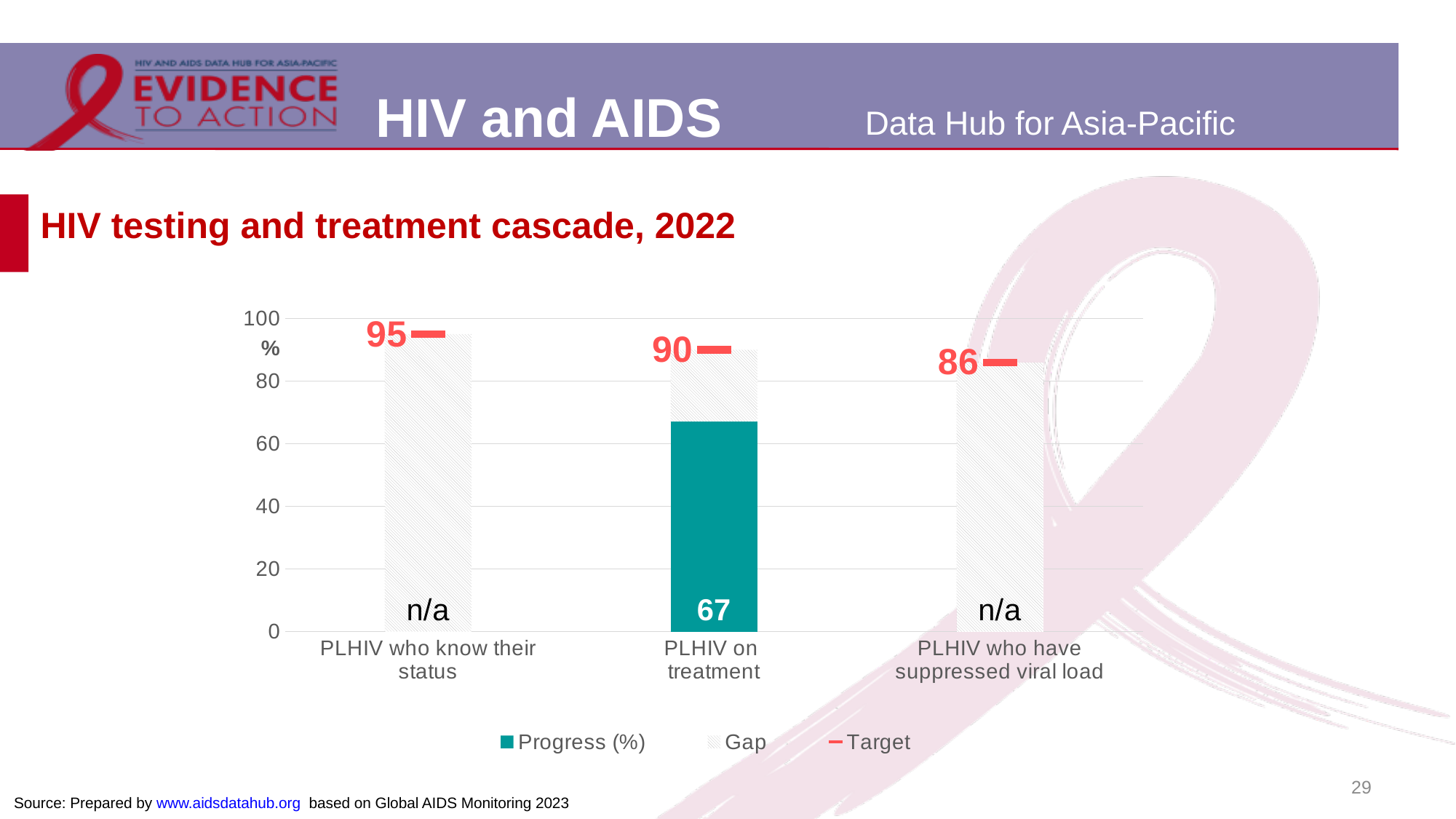
Is the Progress (%) value for PLHIV on treatment greater or less than 60? greater What is the Target value for PLHIV on treatment? 90 What is the Target value for PLHIV who know their status? 95 How many series does the legend list? 3 How many categories are shown on the x axis? 3 What kind of chart is shown on the slide? bar chart What is the difference between the Target and the Progress (%) for PLHIV on treatment? 23 What is the Progress (%) value for PLHIV on treatment? 67 What is the Target value for PLHIV who have suppressed viral load? 86 Which category has the highest Target value? PLHIV who know their status What is the Progress (%) label shown for PLHIV who know their status? n/a Which category has the lowest Target value? PLHIV who have suppressed viral load